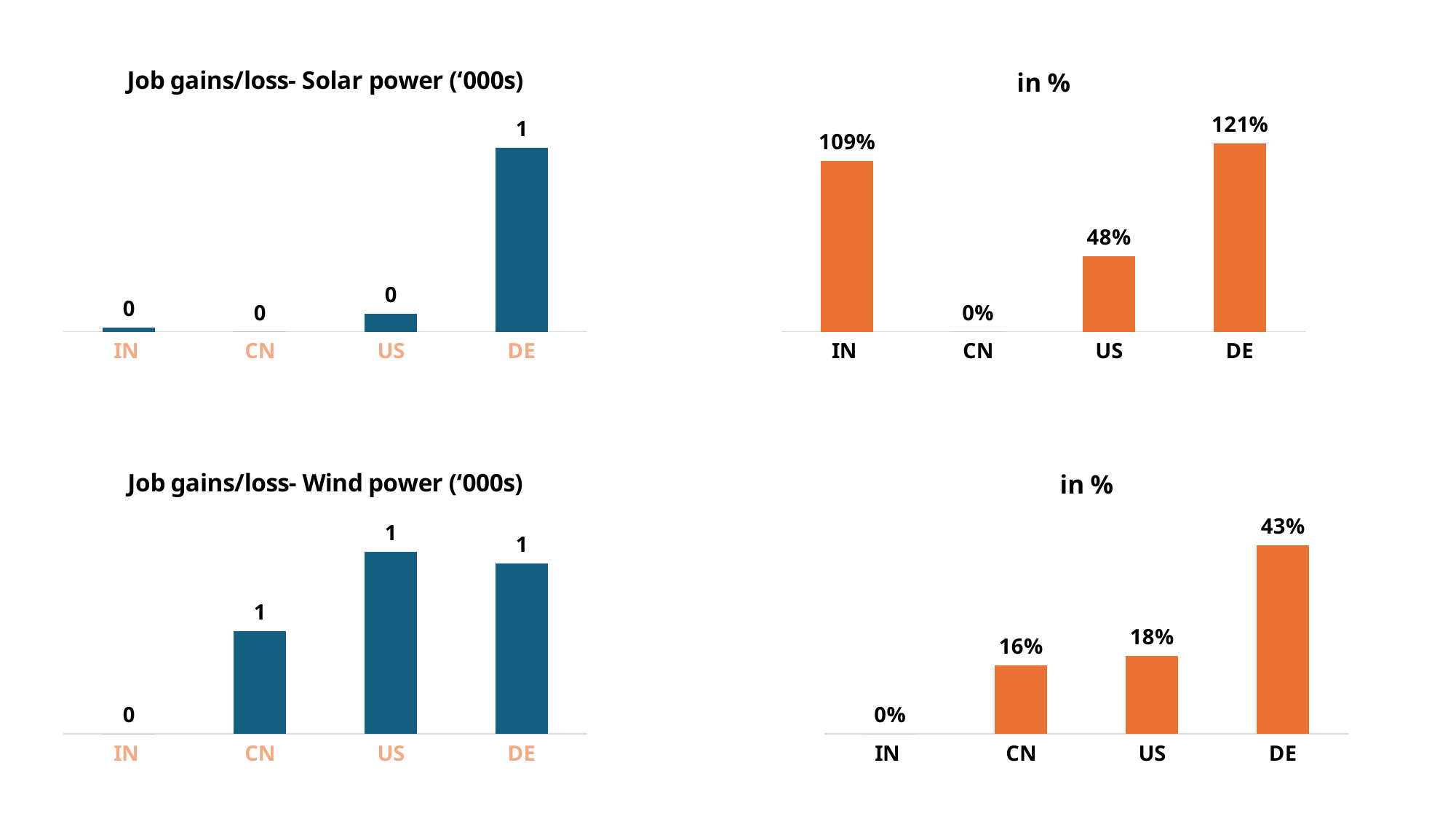
In the chart titled 'Job gains/loss- Solar power ('000s)', which category has the highest value? DE How many categories are shown in the chart titled 'Job gains/loss- Wind power ('000s)'? 4 In the top-right chart (in %, solar power), what is the value for IN? 109% In the top-right chart (in %, solar power), which category has the lowest value? CN In the top-right chart (in %, solar power), which category has the highest value? DE What kind of chart is the chart titled 'Job gains/loss- Solar power ('000s)'? Bar chart In the bottom-right chart (in %, wind power), what is the value for DE? 43% In the bottom-right chart (in %, wind power), what is the difference between the values for DE and US? 25% In the bottom-right chart (in %, wind power), which is larger, the value for US or the value for CN? US In the top-right chart (in %, solar power), what is the difference between the values for DE and IN? 12% In the bottom-right chart (in %, wind power), which category has the lowest value? IN In the chart titled 'Job gains/loss- Wind power ('000s)', what is the value for CN? 1